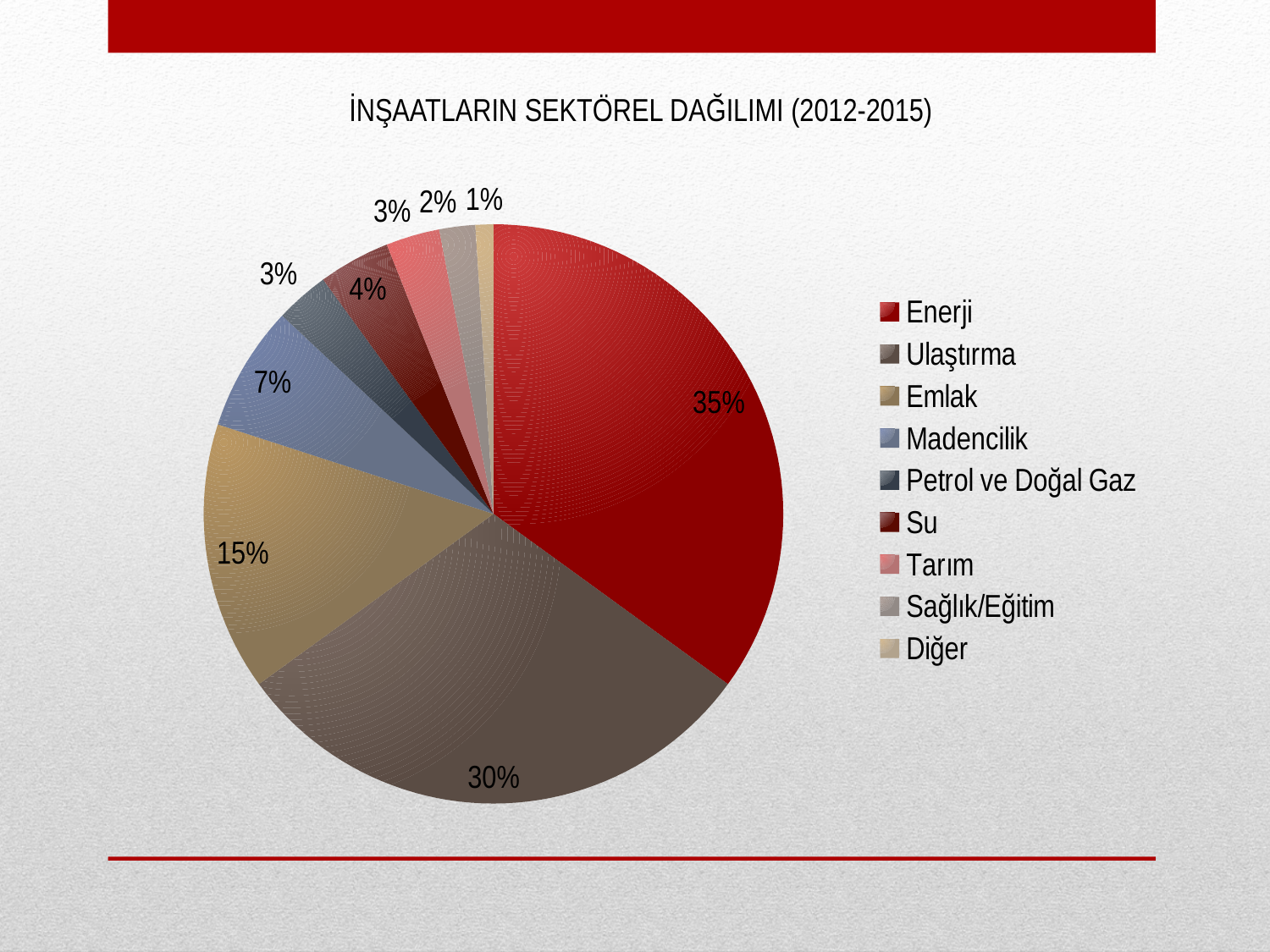
What share of the pie does Ulaştırma have? 30% Which sector has the smallest share of the pie? Diğer What share of the pie does Su have? 4% What share of the pie does Enerji have? 35% What share of the pie does Madencilik have? 7% What is the title of the chart? İNŞAATLARIN SEKTÖREL DAĞILIMI (2012-2015) What share of the pie does Emlak have? 15% Which sector has the largest share of the pie? Enerji What type of chart is shown on the slide? pie chart Which has a larger share, Emlak or Madencilik? Emlak How many sectors does the legend list? 9 What is the difference between the shares of Enerji and Ulaştırma? 5%